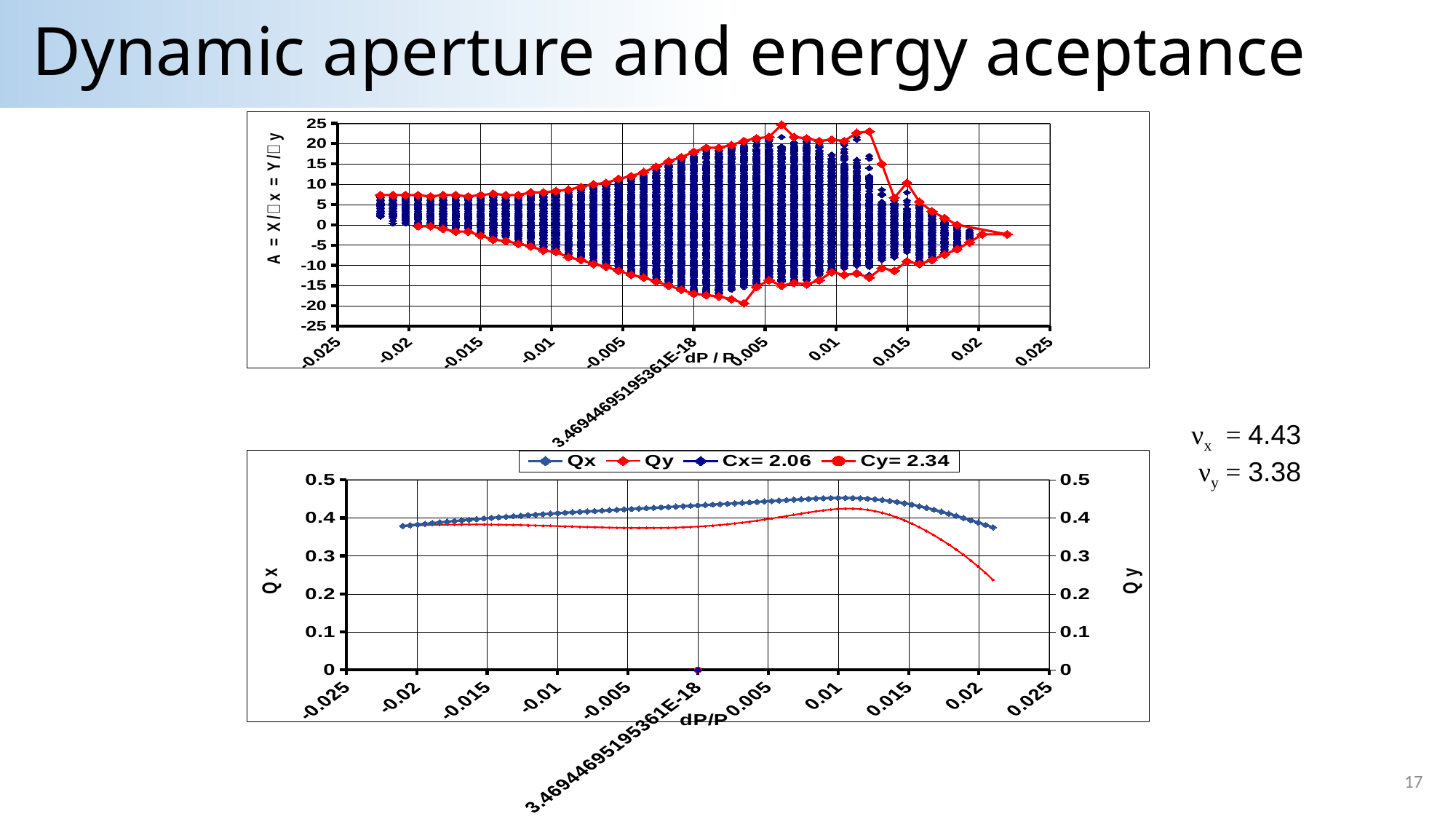
What kind of chart is the bottom chart? line chart In the bottom chart, does Qy rise or fall as dP/P goes from 0.01 to 0.02? falls In the bottom chart, does Qx rise or fall as dP/P goes from -0.02 to 0.01? rises In the top chart, is the upper red boundary at dP/P = -0.02 greater or less than 10? less In the bottom chart, is the value of Qy at dP/P = 0.02 greater or less than 0.4? less In the bottom chart, at dP/P = 0.02, which is larger, Qx or Qy? Qx In the top chart, is the lower red boundary at dP/P = 0 greater or less than -15? less In the bottom chart, what is the title of the right-hand y-axis? Q y In the top chart, does the upper red boundary rise or fall as dP/P goes from -0.01 to 0.005? rises In the bottom chart, what is the x-axis title? dP/P In the bottom chart, how many series does the legend list? 4